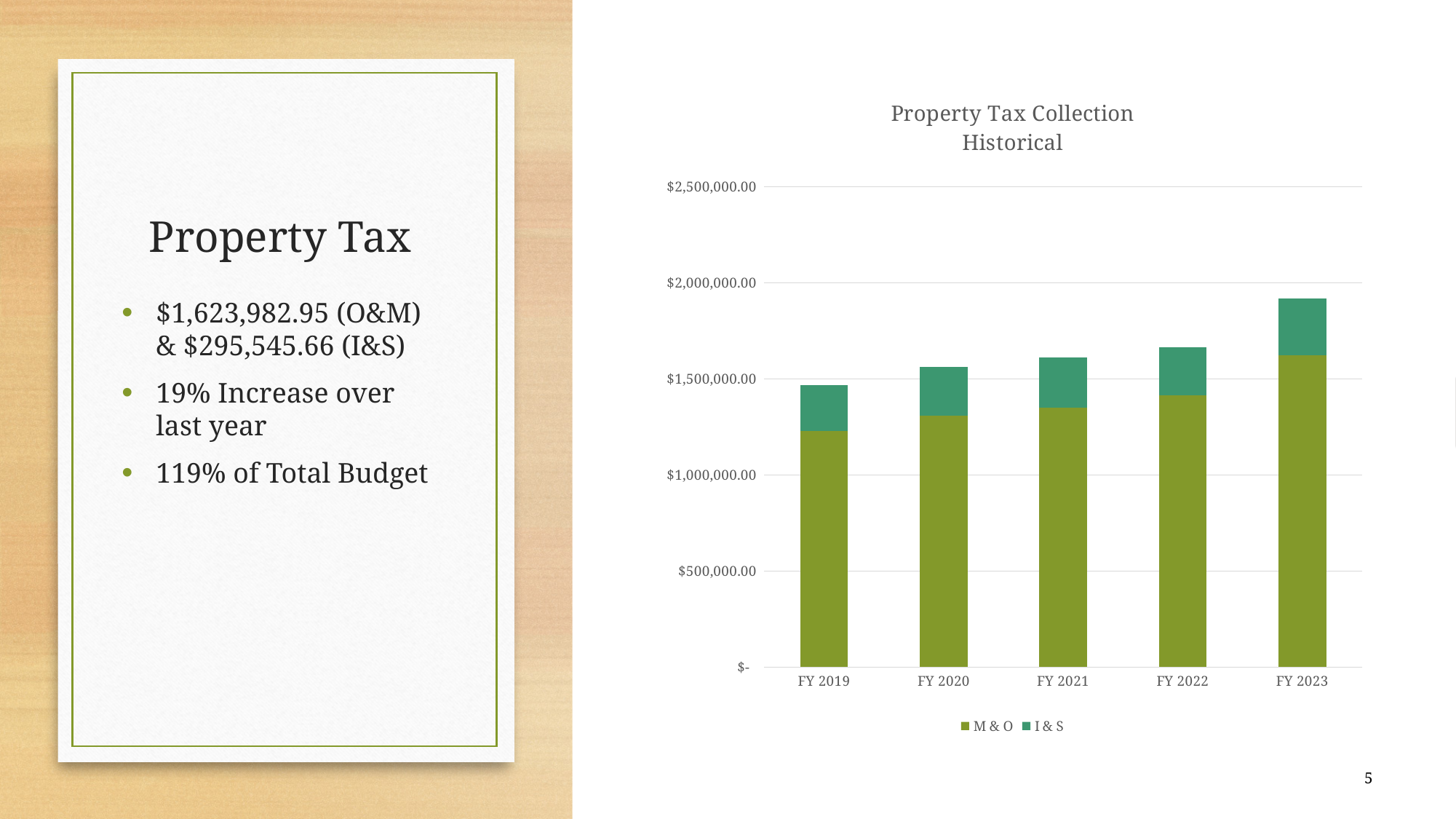
What kind of chart is shown on the slide? Stacked bar chart Is the total bar for FY 2023 greater or less than $1,500,000.00? greater How many fiscal years are shown on the x axis of the chart? 5 Which fiscal year has the lowest total property tax collection in the chart? FY 2019 What is the title of the chart? Property Tax Collection Historical Do the total property tax collections rise or fall from FY 2019 to FY 2023? Rise Is the M & O value for FY 2023 greater or less than $1,500,000.00? greater Is the total bar for FY 2019 greater or less than $1,500,000.00? less How many series does the chart legend list? 2 Which fiscal year has the highest total property tax collection in the chart? FY 2023 Which is larger, the M & O value for FY 2019 or the M & O value for FY 2023? FY 2023